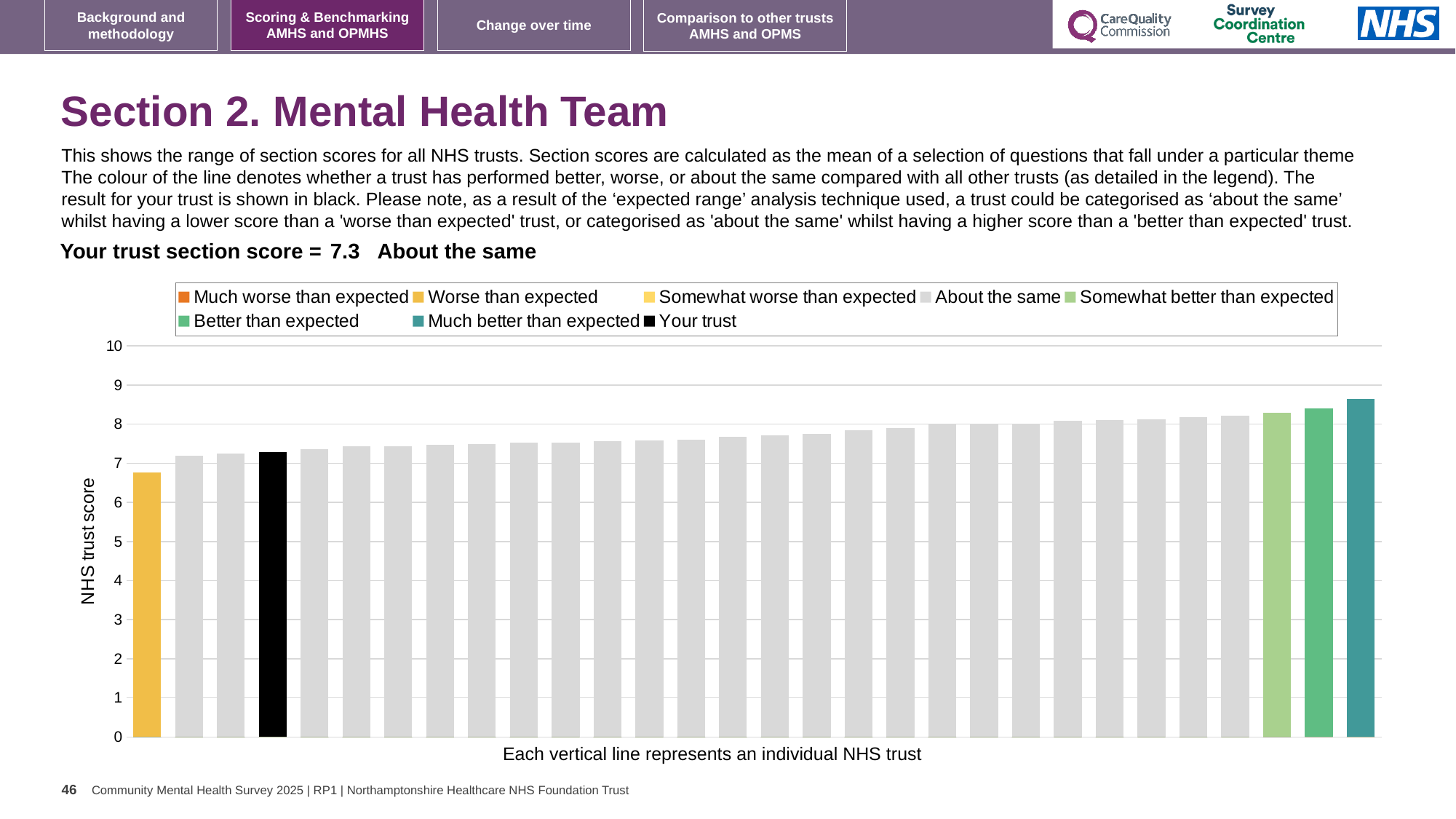
Do the bar values rise or fall from left to right along the x axis? rise How many entries does the chart legend list? 8 Is the value of the rightmost bar greater or less than 8? greater Is the value of the leftmost (yellow) bar greater or less than 7? less Which is larger: the leftmost yellow bar or the black 'Your trust' bar? the black 'Your trust' bar What type of chart is shown on the slide? bar chart What colour is the bar representing your trust? black What is the section score for your trust shown on the slide? 7.3 Is the value of the black 'Your trust' bar greater or less than 8? less Which category is your trust placed in for this section score? About the same What is the label on the vertical axis of the chart? NHS trust score